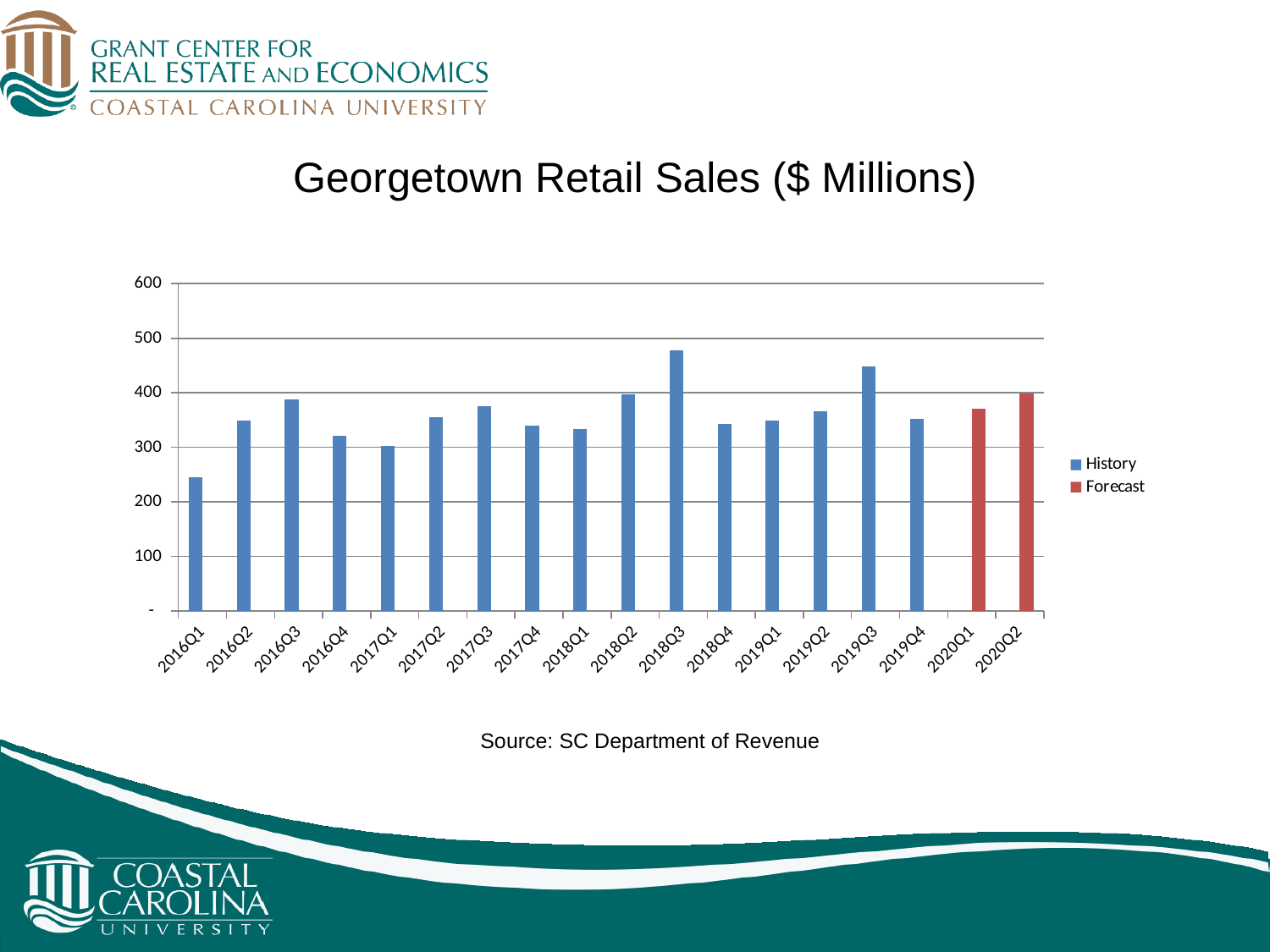
How many series does the legend list? 2 Is the value for 2016Q4 greater or less than 300? greater Is the value for 2016Q1 greater or less than 300? less Which is larger, the value for 2018Q3 or the value for 2019Q3? 2018Q3 How many quarters are plotted along the x axis? 18 Is the value for 2018Q3 greater or less than 400? greater What type of chart is shown on the slide? Bar chart What is the title of the chart? Georgetown Retail Sales ($ Millions) Which quarter has the lowest retail sales? 2016Q1 Which is larger, the value for 2016Q1 or the value for 2016Q2? 2016Q2 Which quarter has the highest retail sales? 2018Q3 What are the two series named in the legend? History and Forecast